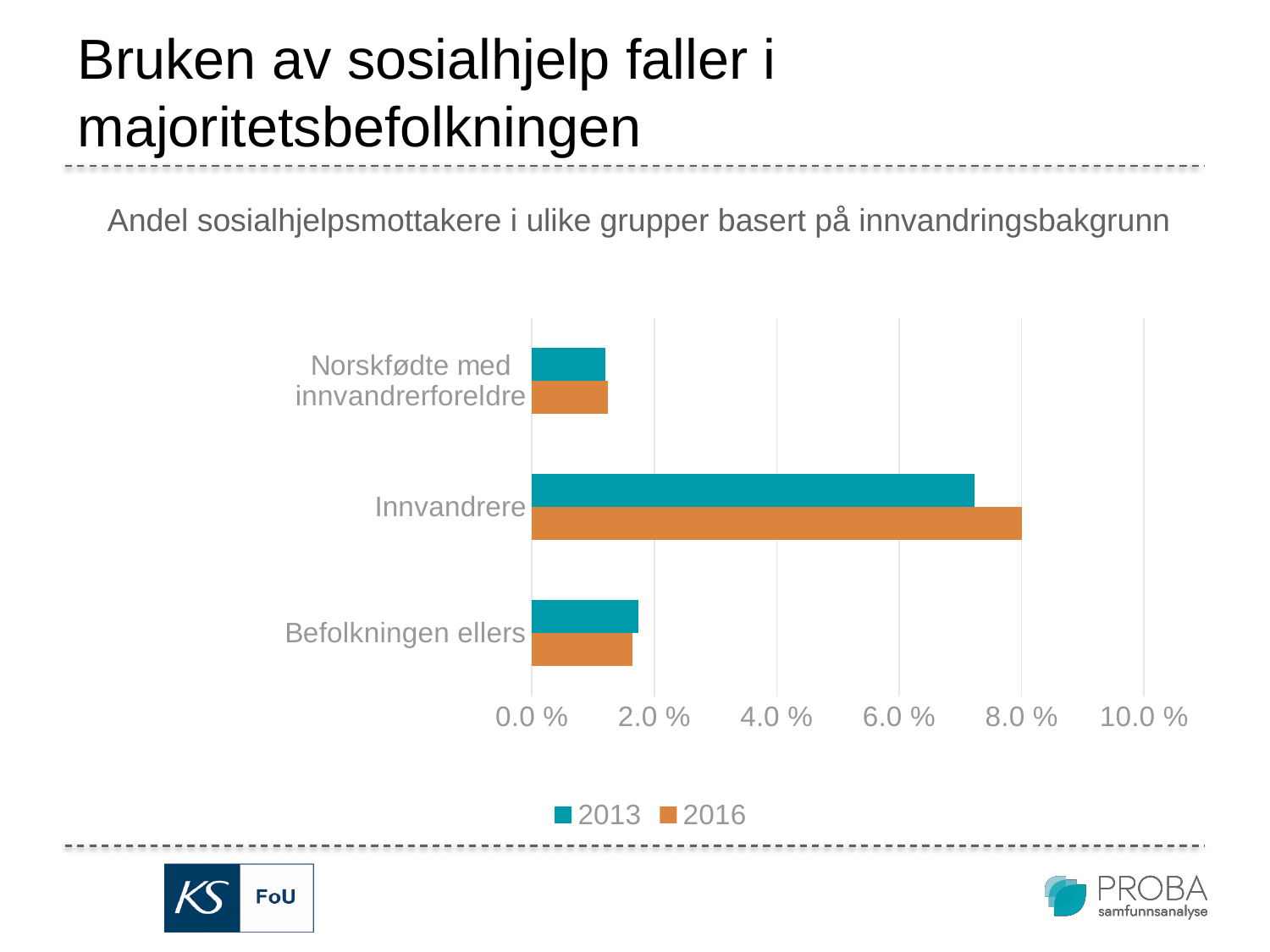
Is the 2013 value for Befolkningen ellers greater or less than 2.0 %? less What kind of chart is shown on the slide? bar chart Which series is shown in orange according to the legend? 2016 How many series does the legend list? 2 How many categories are shown on the chart? 3 Which category has the highest value for 2016? Innvandrere Is the 2013 value for Innvandrere greater or less than 6.0 %? greater Which category has the highest value for 2013? Innvandrere What is the title of the chart? Andel sosialhjelpsmottakere i ulike grupper basert på innvandringsbakgrunn For Innvandrere, which year has the larger value, 2013 or 2016? 2016 Which category has the lowest value for 2013? Norskfødte med innvandrerforeldre Is the 2016 value for Innvandrere greater or less than 10.0 %? less